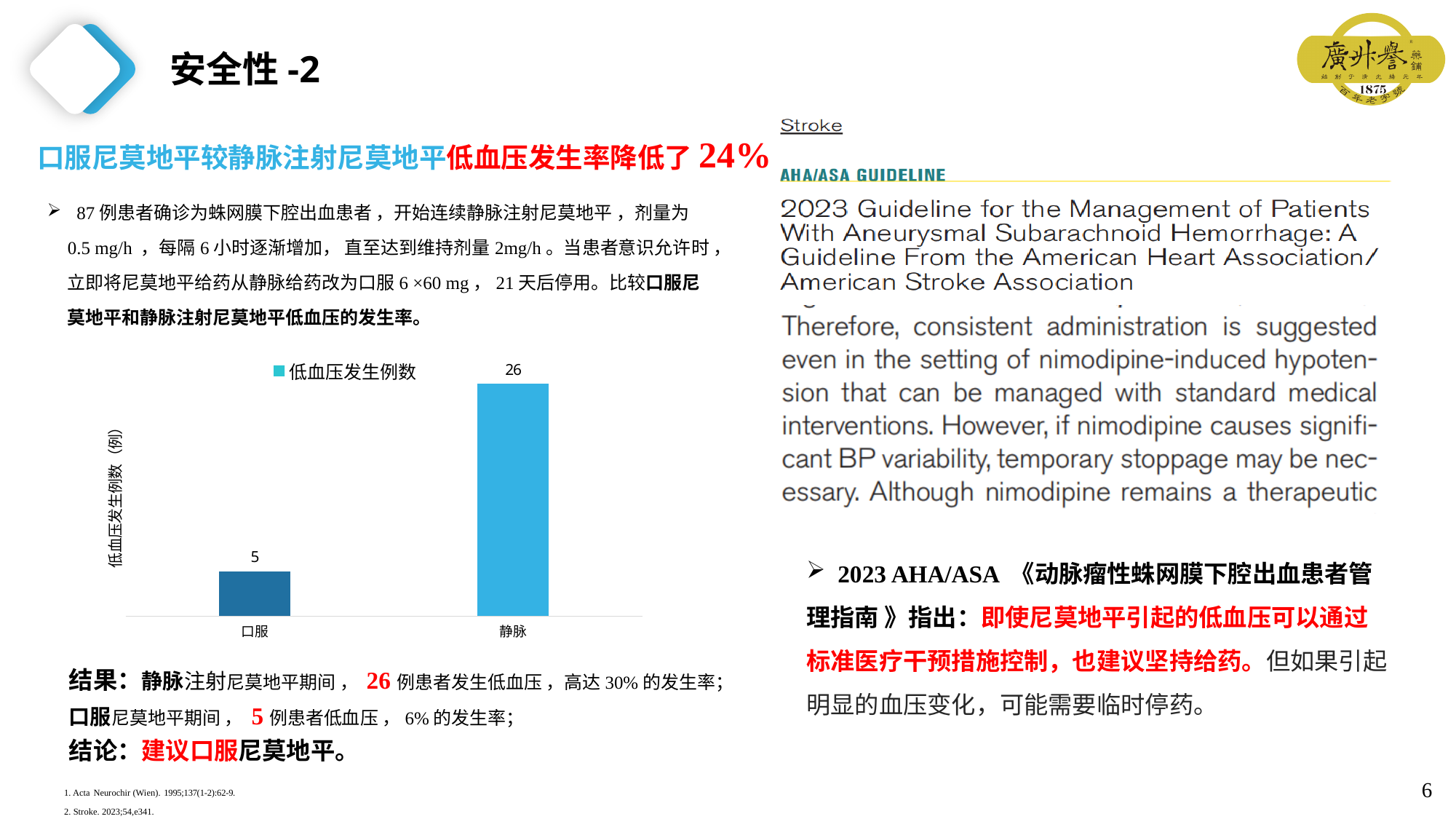
Do the values rise or fall from 口服 to 静脉 along the x axis? rise Which is larger, the value for 口服 or the value for 静脉? 静脉 What is the y-axis label of the chart? 低血压发生例数（例） How many categories are shown on the x axis of the chart? 2 What is the value for 静脉 in the chart? 26 What kind of chart is shown on the slide? bar chart Which category has the highest value in the chart? 静脉 What is the legend entry of the chart? 低血压发生例数 Which category has the lowest value in the chart? 口服 How many series does the chart legend list? 1 What is the value for 口服 in the chart? 5 What is the difference between the values for 静脉 and 口服? 21